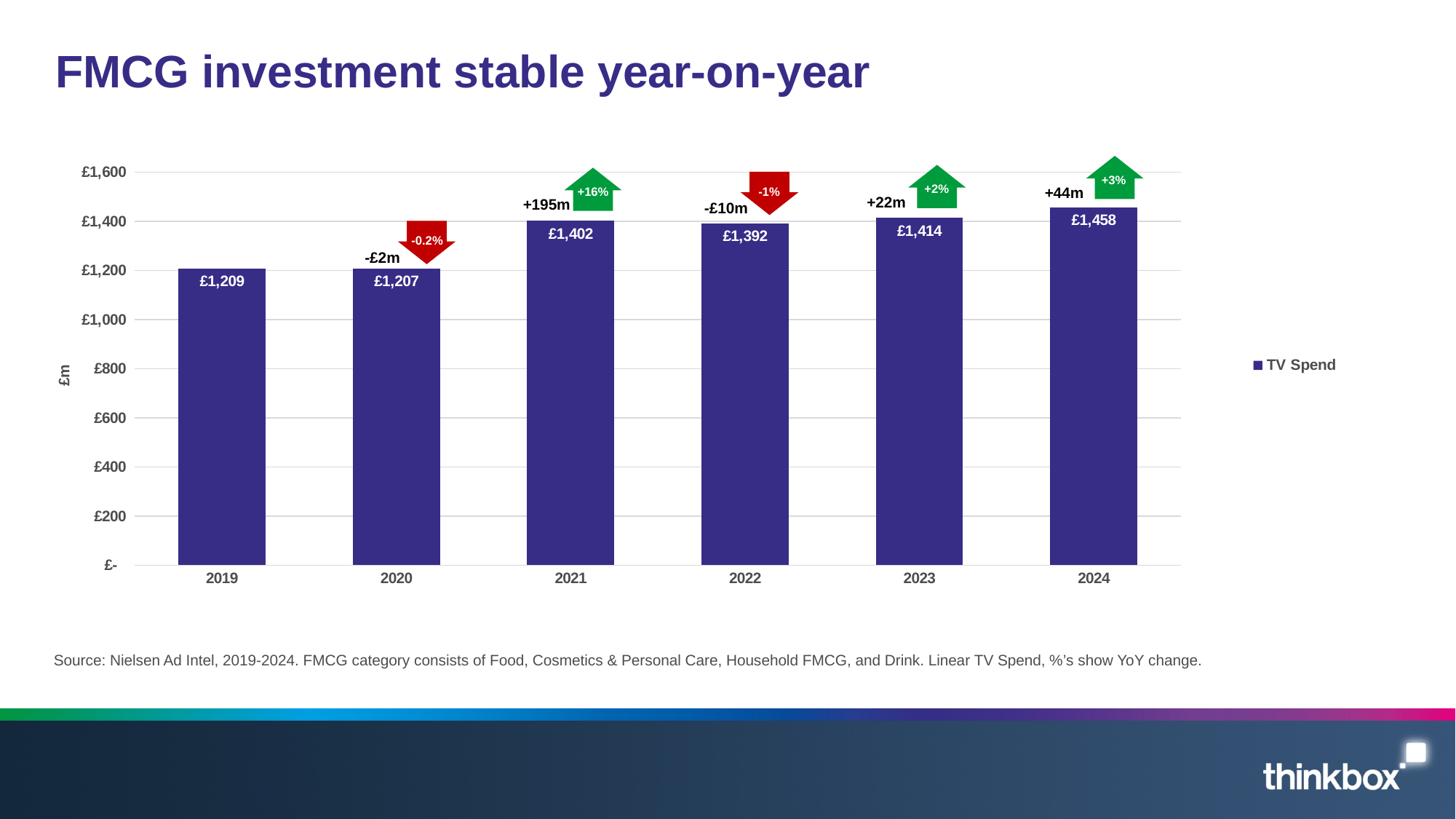
Which year has the highest TV Spend? 2024 What kind of chart is shown on the slide? Bar chart How many years are shown on the x axis? 6 What is the TV Spend value for 2022? £1,392 What is the difference in TV Spend between 2021 and 2020? £195 Is the TV Spend value for 2023 greater or less than £1,400? greater What is the year-on-year percentage change shown for 2021? +16% How many series does the legend list? 1 Which year has the lowest TV Spend? 2020 What is the TV Spend value for 2024? £1,458 What is the TV Spend value for 2019? £1,209 Which year has the larger TV Spend, 2021 or 2022? 2021